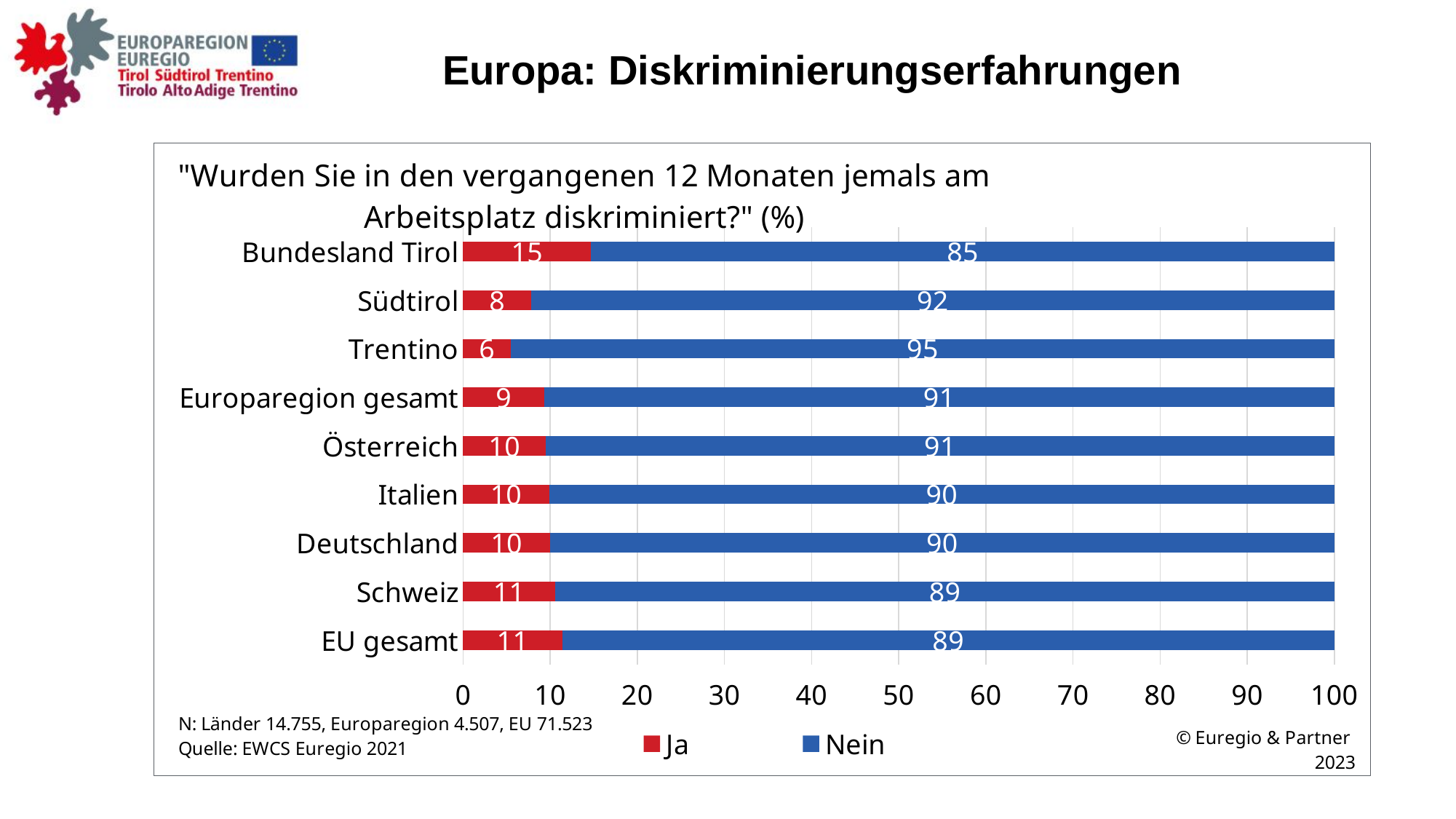
What is the "Ja" value for Europaregion gesamt? 9 Which category has the highest "Ja" value? Bundesland Tirol What kind of chart is shown on the slide? Stacked bar chart What is the difference between the "Ja" values for Bundesland Tirol and Südtirol? 7 Which has a larger "Nein" value, Südtirol or Schweiz? Südtirol What is the "Ja" value for Bundesland Tirol? 15 How many categories are shown on the chart? 9 Which category has the lowest "Ja" value? Trentino What is the "Nein" value for Trentino? 95 How many series does the legend list? 2 Is the "Nein" value for Bundesland Tirol greater or less than 80? greater Which colour represents the "Ja" series? Red